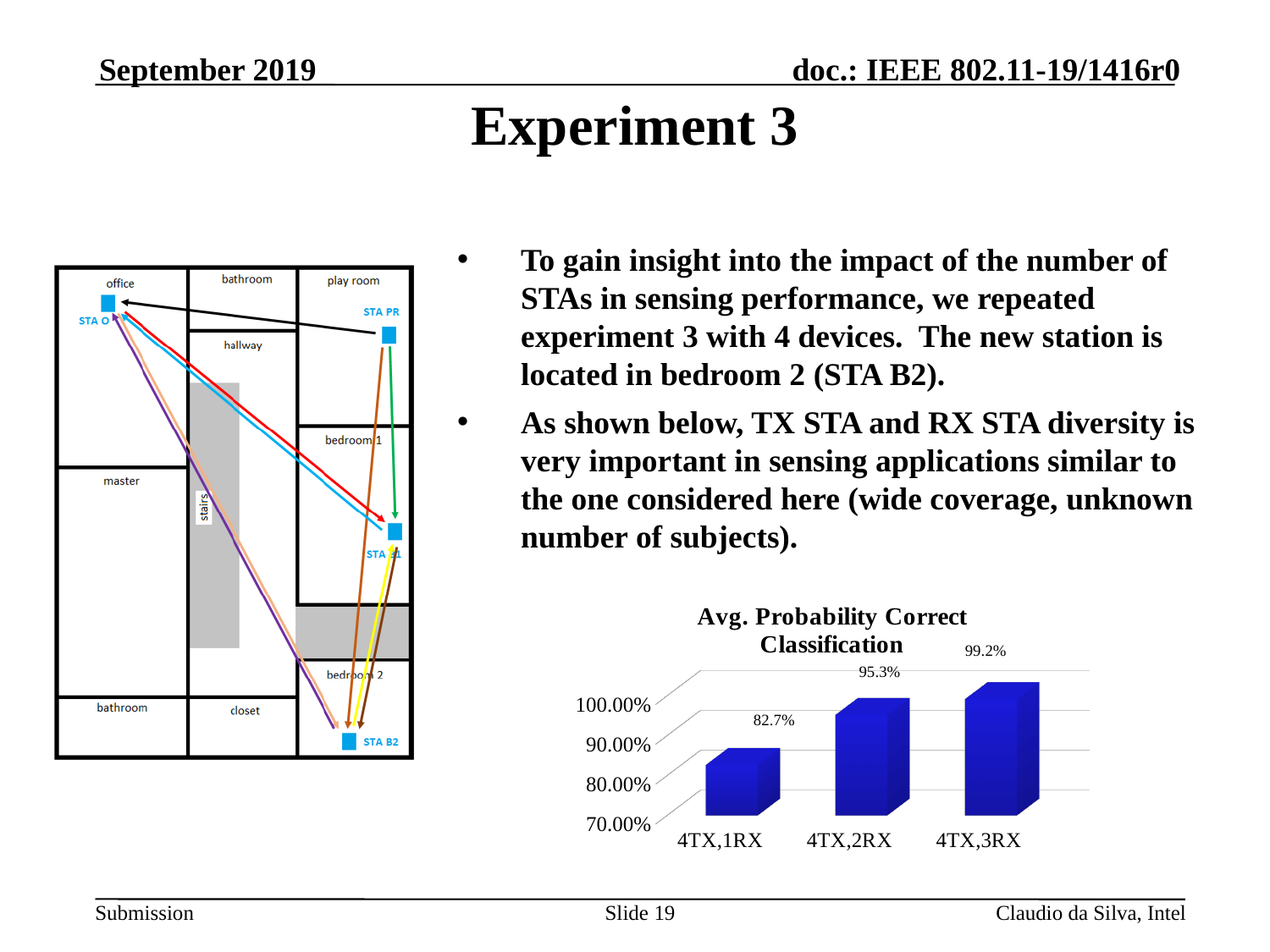
What is the value for 4TX,1RX in the Avg. Probability Correct Classification chart? 82.7% Which category has the highest value in the Avg. Probability Correct Classification chart? 4TX,3RX What kind of chart is the Avg. Probability Correct Classification chart? bar chart Which is larger in the Avg. Probability Correct Classification chart, the value for 4TX,2RX or 4TX,1RX? 4TX,2RX Is the value for 4TX,1RX in the Avg. Probability Correct Classification chart greater or less than 90.00%? less Which category has the lowest value in the Avg. Probability Correct Classification chart? 4TX,1RX What is the value for 4TX,2RX in the Avg. Probability Correct Classification chart? 95.3% Do the values in the Avg. Probability Correct Classification chart rise or fall from 4TX,1RX to 4TX,3RX? rise What is the value for 4TX,3RX in the Avg. Probability Correct Classification chart? 99.2% How many categories are shown in the Avg. Probability Correct Classification chart? 3 What is the difference between the values for 4TX,3RX and 4TX,1RX in the Avg. Probability Correct Classification chart? 16.5% What is the difference between the values for 4TX,2RX and 4TX,1RX in the Avg. Probability Correct Classification chart? 12.6%